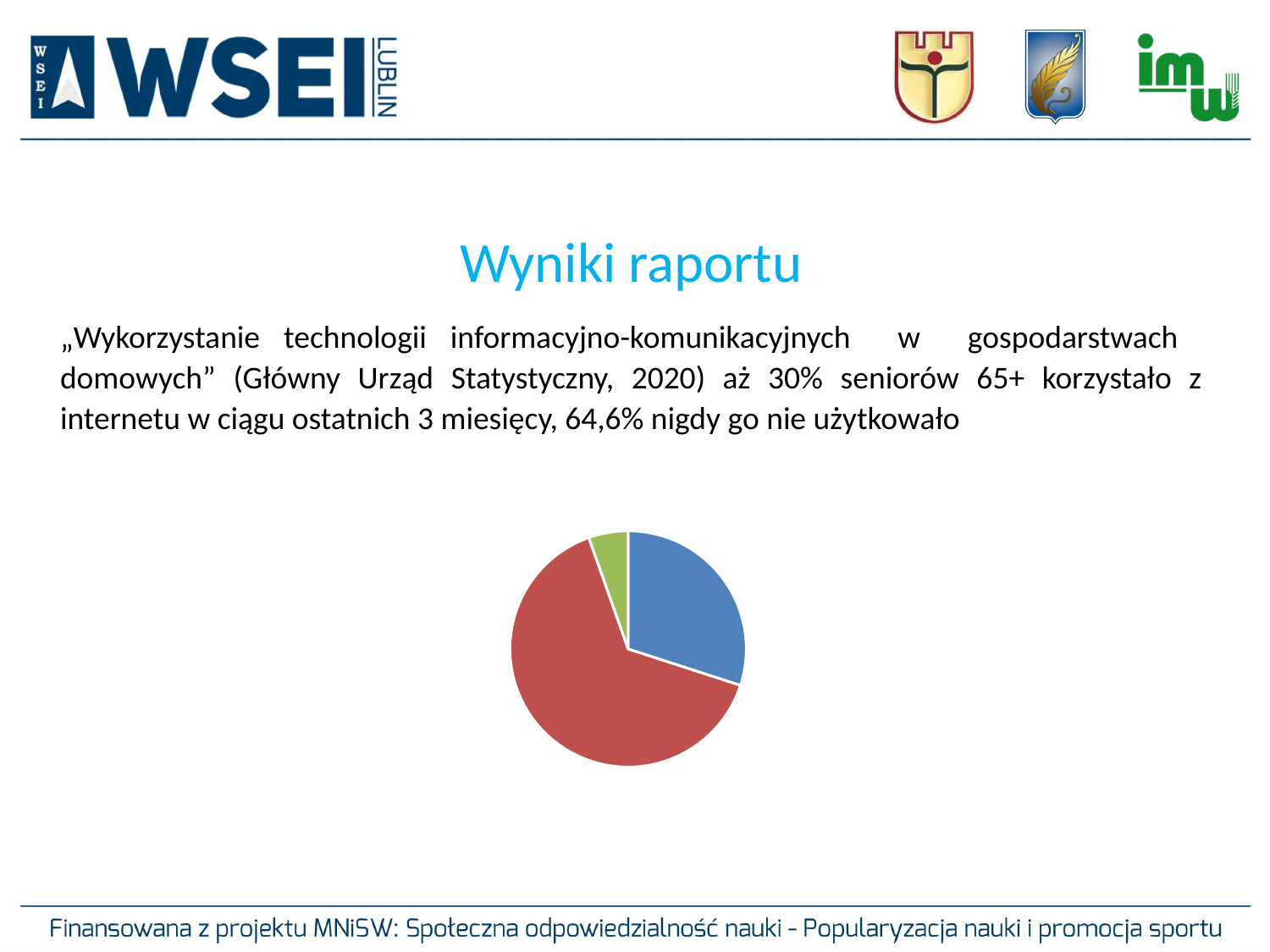
Which slice is larger in the pie chart, the blue one or the green one? blue Which colour slice is the smallest in the pie chart? green Does the pie chart display a legend? No Which colour slice is the largest in the pie chart? red What kind of chart is shown on the slide? pie chart What three colours are used for the slices of the pie chart? blue, red and green Does the red slice take up more or less than half of the pie chart? more How many slices does the pie chart have? 3 Which slice is larger in the pie chart, the blue one or the red one? red